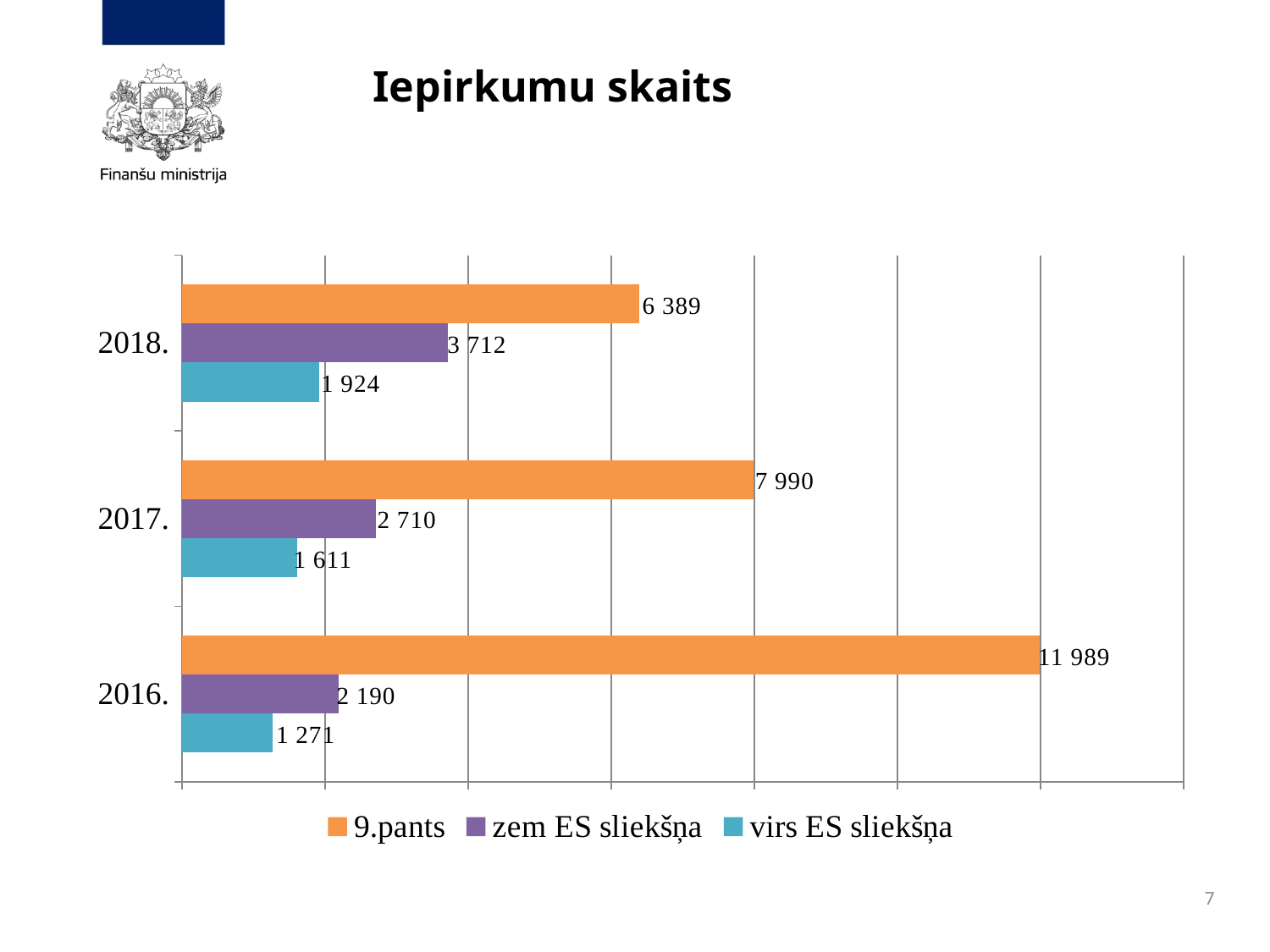
What is the total of the three values for 2018? 12 025 What is the value for virs ES sliekšņa in 2017? 1 611 Which series is shown in orange? 9.pants What is the value for 9.pants in 2016? 11 989 How many series does the legend list? 3 Which is larger: zem ES sliekšņa in 2017 or zem ES sliekšņa in 2016? zem ES sliekšņa in 2017 What is the difference between the 9.pants values for 2017 and 2018? 1 601 In which year is the 9.pants value highest? 2016. How many years are shown on the chart? 3 What kind of chart is shown on the slide? bar chart What is the value for zem ES sliekšņa in 2018? 3 712 In which year is the virs ES sliekšņa value lowest? 2016.